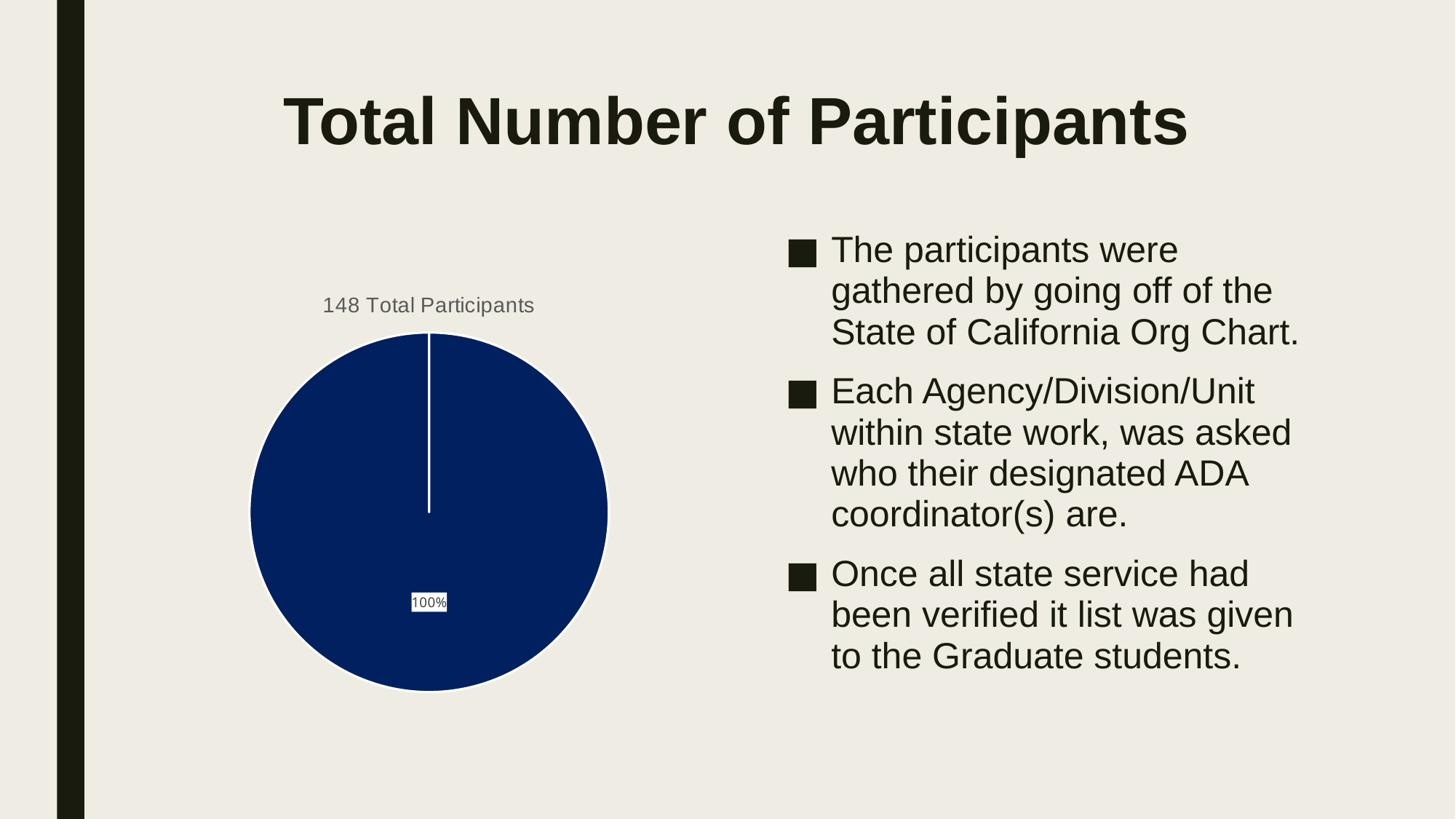
What is the title of the chart? 148 Total Participants What share of the pie does the single slice represent? 100% What colour is the pie slice? dark blue How many total participants does the chart title state? 148 What percentage label is printed on the pie slice? 100% How many slices does the pie chart have? 1 What kind of chart is shown on the slide? pie chart